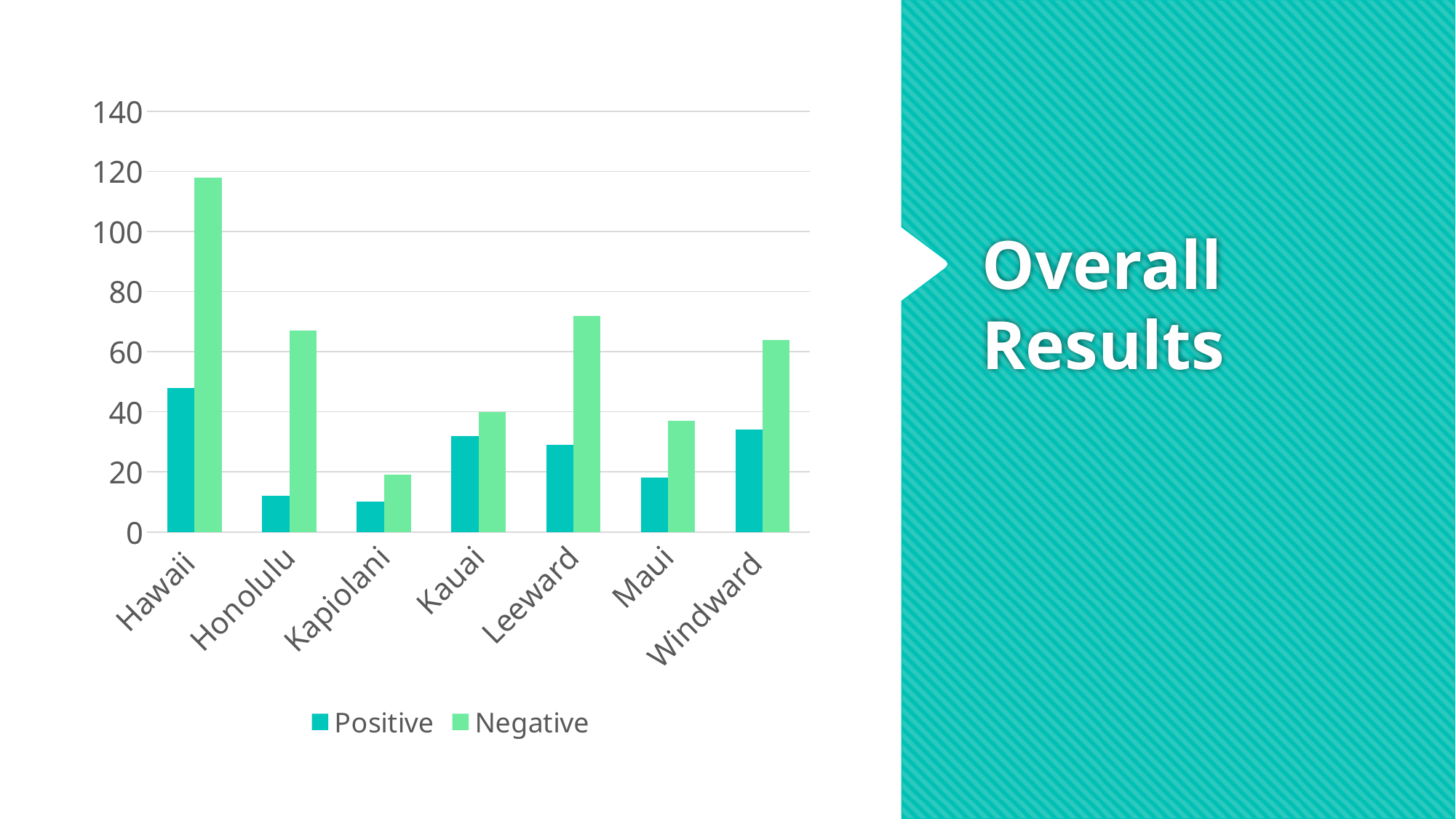
How many series does the chart's legend list? 2 Which campus has a larger Negative value, Honolulu or Kauai? Honolulu Is the Negative value for Hawaii greater or less than 100? greater Which is larger for Maui, the Positive value or the Negative value? Negative Is the Positive value for Honolulu greater or less than 20? less Which campus has the highest Negative value? Hawaii Is the Negative value for Leeward greater or less than 60? greater Which campus has the lowest Negative value? Kapiolani What kind of chart is shown on the slide? bar chart How many campuses (categories) are shown on the x axis of the chart? 7 Which campus has the lowest Positive value? Kapiolani What are the two series named in the chart's legend? Positive and Negative